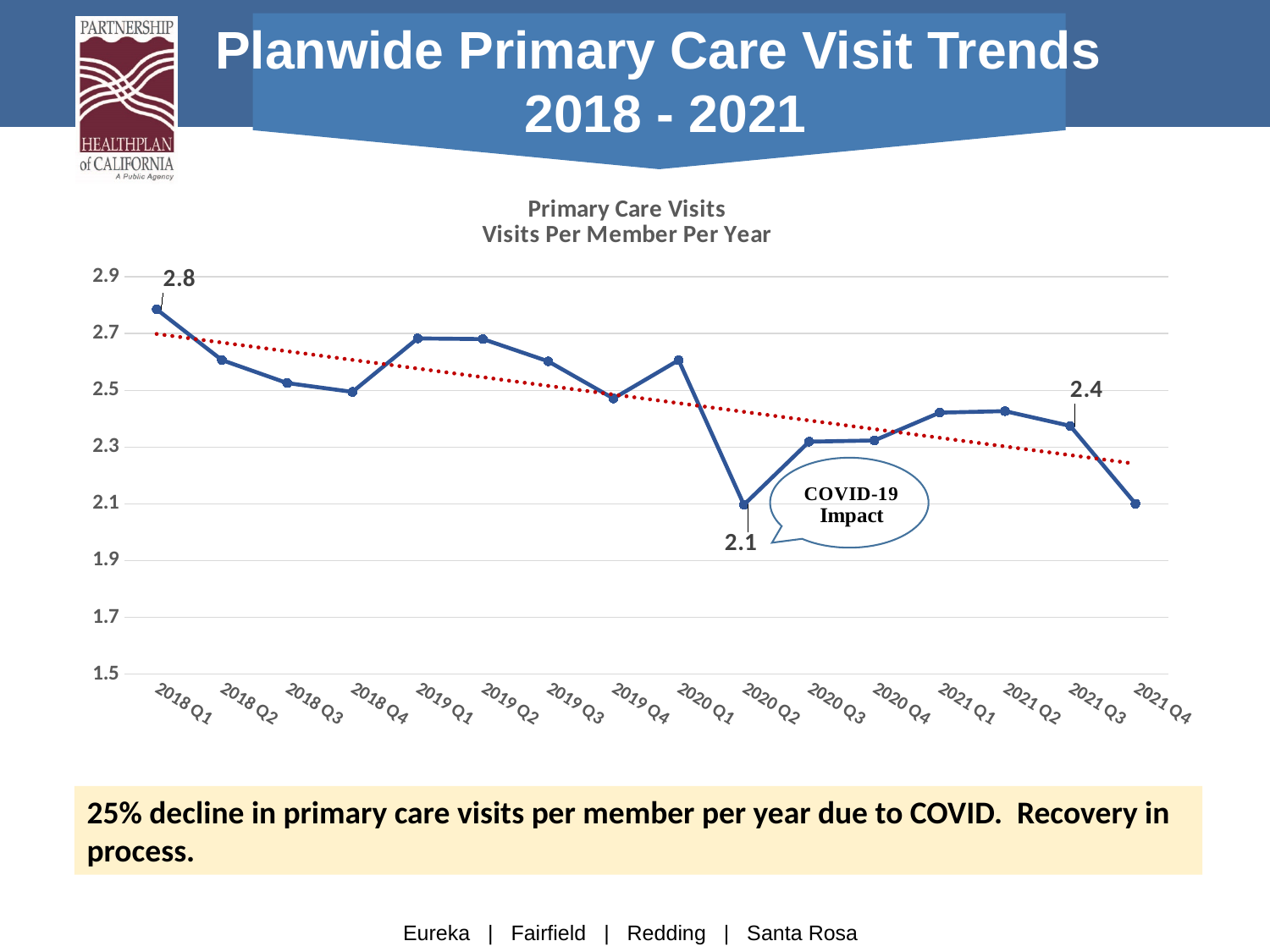
How many quarters are plotted on the x axis? 16 What is the value for 2018 Q1? 2.8 What kind of chart is shown? line chart Which quarter has the highest value? 2018 Q1 Is the value for 2020 Q3 greater or less than 2.5? less Which is larger, the value for 2018 Q1 or the value for 2021 Q3? 2018 Q1 What is the difference between the values for 2021 Q3 and 2020 Q2? 0.3 Do the values generally rise or fall from 2018 Q1 to 2021 Q4? fall Is the value for 2019 Q1 greater or less than 2.5? greater What is the difference between the values for 2018 Q1 and 2020 Q2? 0.7 What is the value for 2021 Q3? 2.4 What is the value for 2020 Q2? 2.1